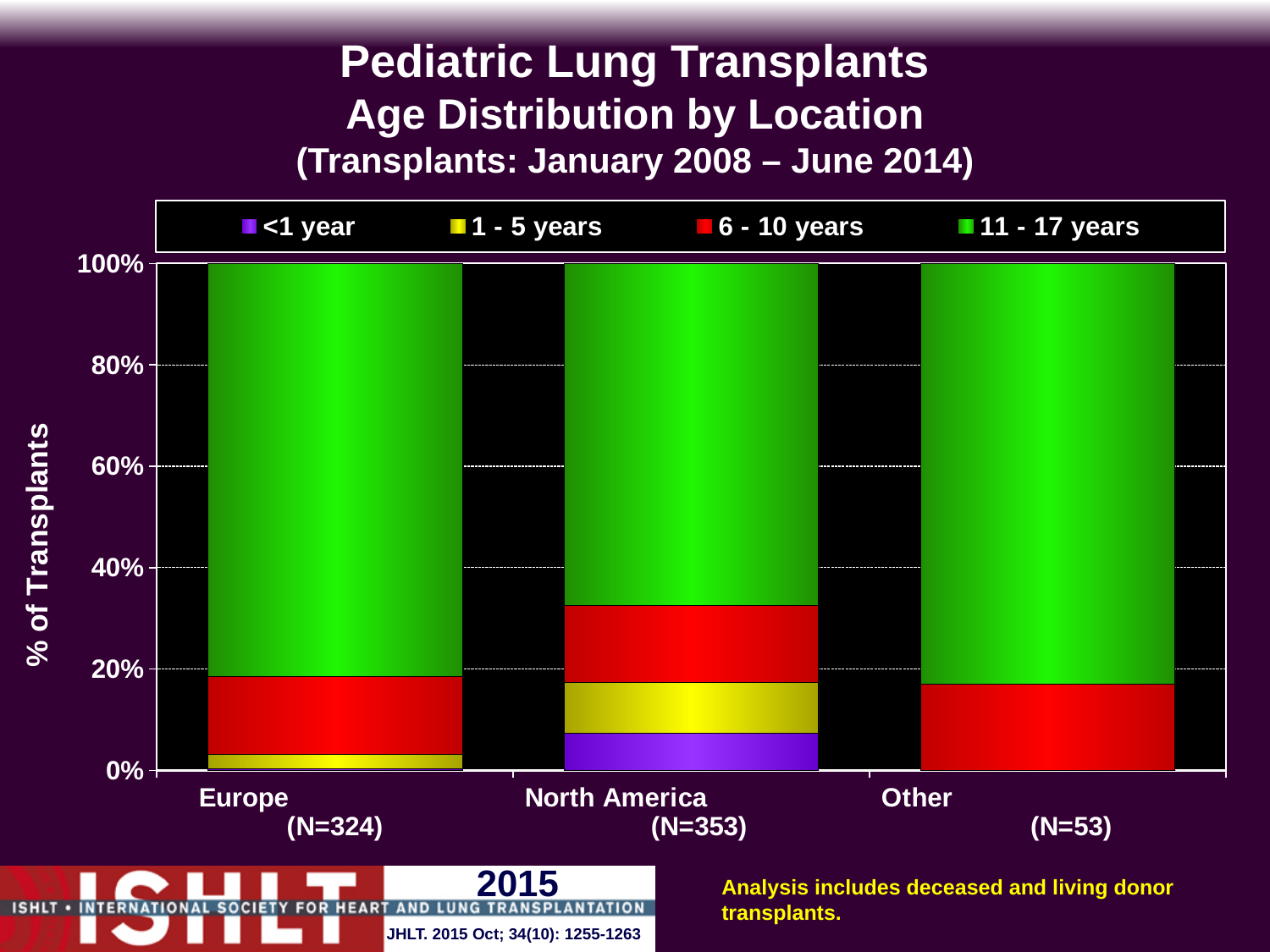
Which location has the largest share of transplants in the 1 - 5 years age group? North America Which location has the smallest share of transplants in the 11 - 17 years age group? North America What kind of chart is shown on the slide? Stacked bar chart What is the label on the y axis of the chart? % of Transplants How many locations are shown on the x axis of the chart? 3 How many age groups does the legend list? 4 Which location has the largest share of transplants in the <1 year age group? North America Is the share of 6 - 10 years transplants in Europe greater or less than 20%? less Is the share of 11 - 17 years transplants in Other greater or less than 60%? greater What is the N value shown for North America? N=353 Is the share of 11 - 17 years transplants in North America greater or less than 60%? greater